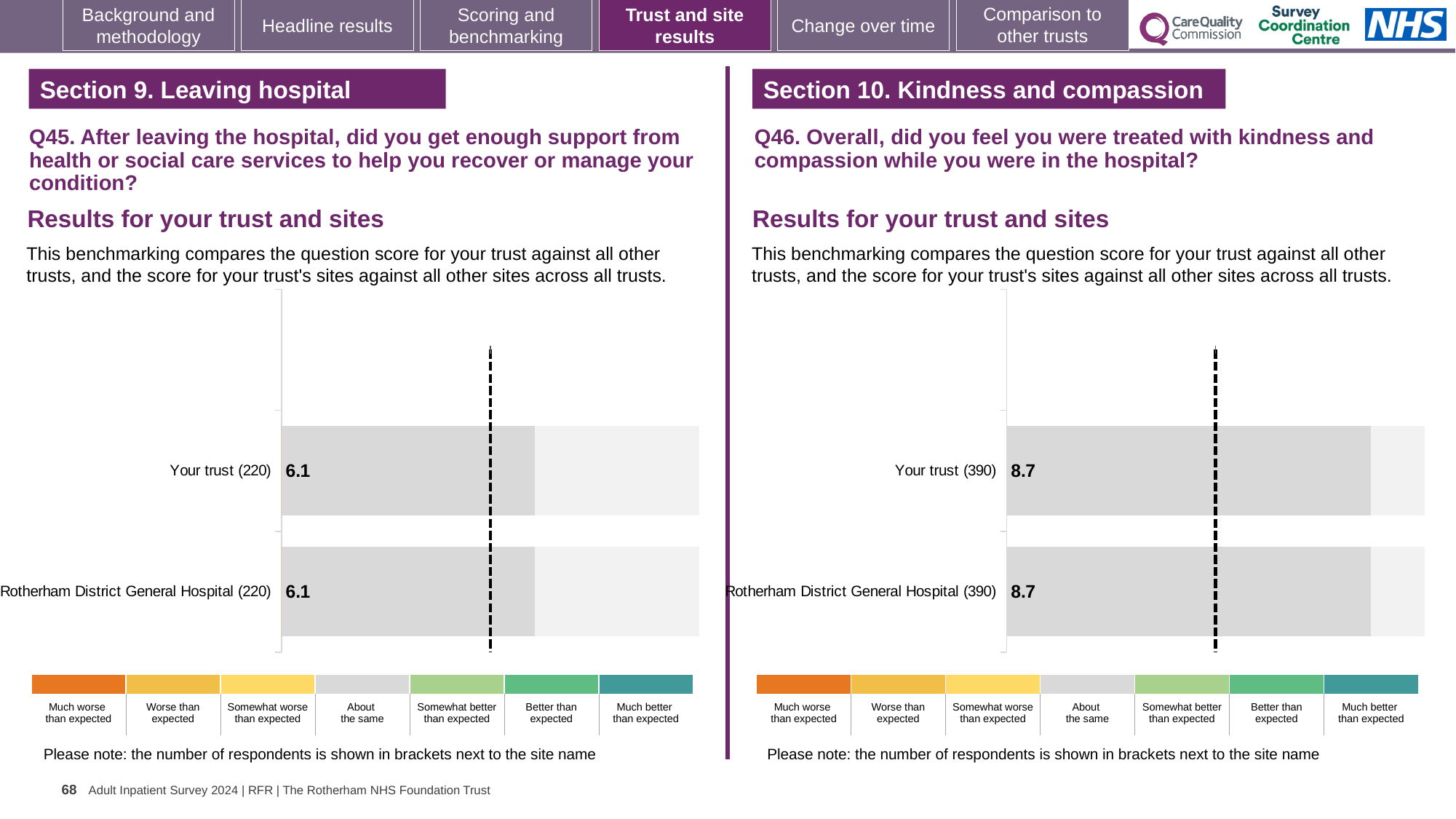
On the Q45 chart (left), what is the score for Rotherham District General Hospital? 6.1 On the Q45 chart (left), how many respondents are shown in brackets for Your trust? 220 On the Q45 chart (left), what is the score for Your trust? 6.1 On the Q46 chart (right), what is the score for Your trust? 8.7 On the Q45 chart (left), what is the difference between the score for Your trust and the score for Rotherham District General Hospital? 0 Is the score for Your trust on the Q46 chart (right) larger or smaller than the score for Your trust on the Q45 chart (left)? Larger How many bars are plotted on the Q46 chart (right)? 2 On the Q46 chart (right), what is the difference between the score for Your trust and the score for Rotherham District General Hospital? 0 What kind of chart is used on the Q46 chart (right)? Bar chart How many bars are plotted on the Q45 chart (left)? 2 On the Q46 chart (right), what is the score for Rotherham District General Hospital? 8.7 On the Q46 chart (right), how many respondents are shown in brackets for Rotherham District General Hospital? 390